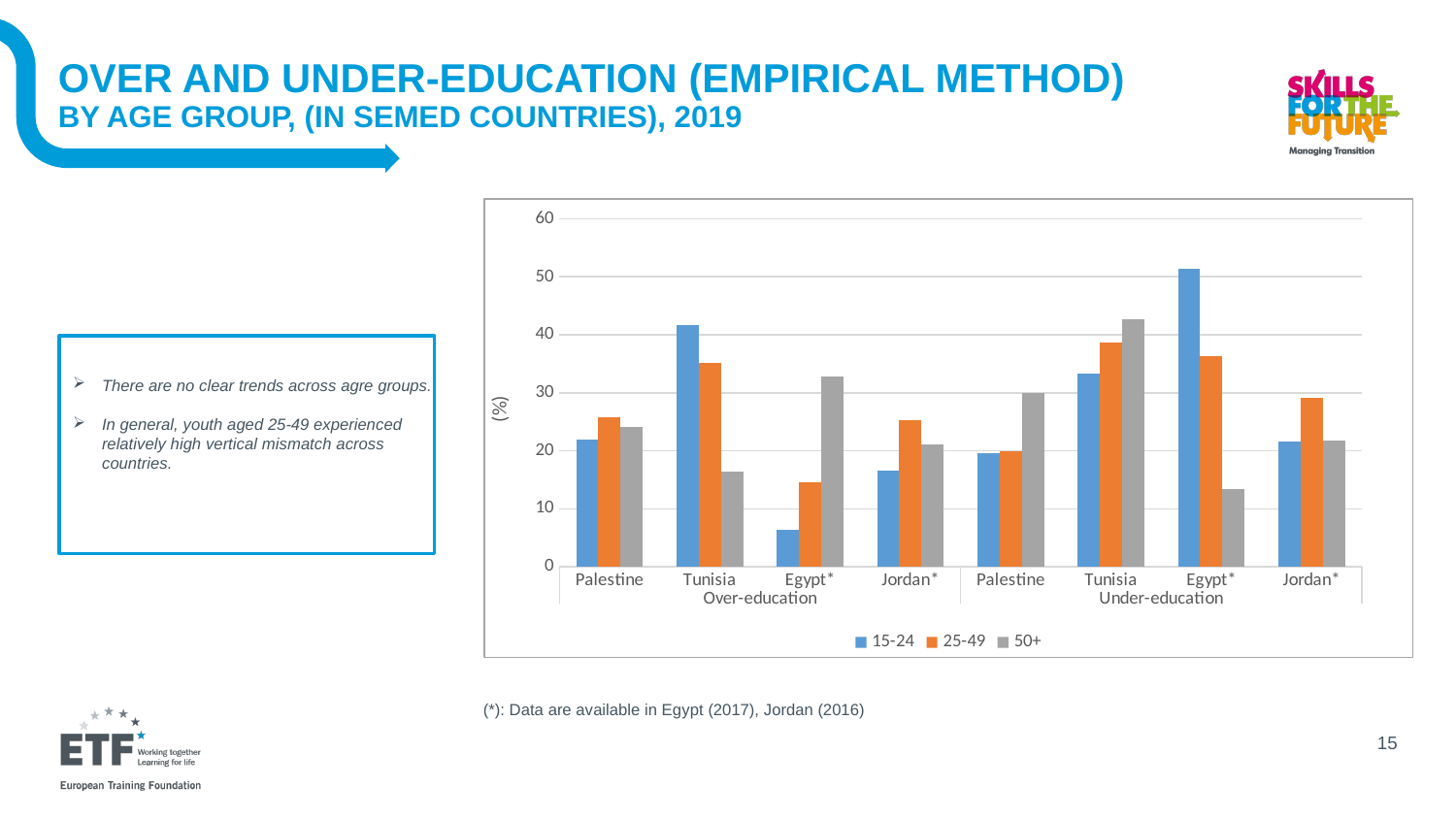
For Under-education in Egypt*, which is larger: the 25-49 bar or the 50+ bar? 25-49 What is the label on the vertical axis of the chart? (%) How many series does the legend list? 3 Is the Over-education value for the 50+ group in Egypt* greater or less than 30? greater For Over-education in Tunisia, which is larger: the 15-24 bar or the 25-49 bar? 15-24 Is the Over-education value for the 15-24 group in Tunisia greater or less than 40? greater Which bar is the highest in the whole chart? 15-24 for Egypt* (Under-education) Which bar is the lowest in the whole chart? 15-24 for Egypt* (Over-education) Which age groups are listed in the legend? 15-24, 25-49, 50+ How many country categories are plotted on the x axis in total (across both Over-education and Under-education)? 8 Is the Over-education value for the 25-49 group in Egypt* greater or less than 20? less What kind of chart is shown on the slide? Bar chart